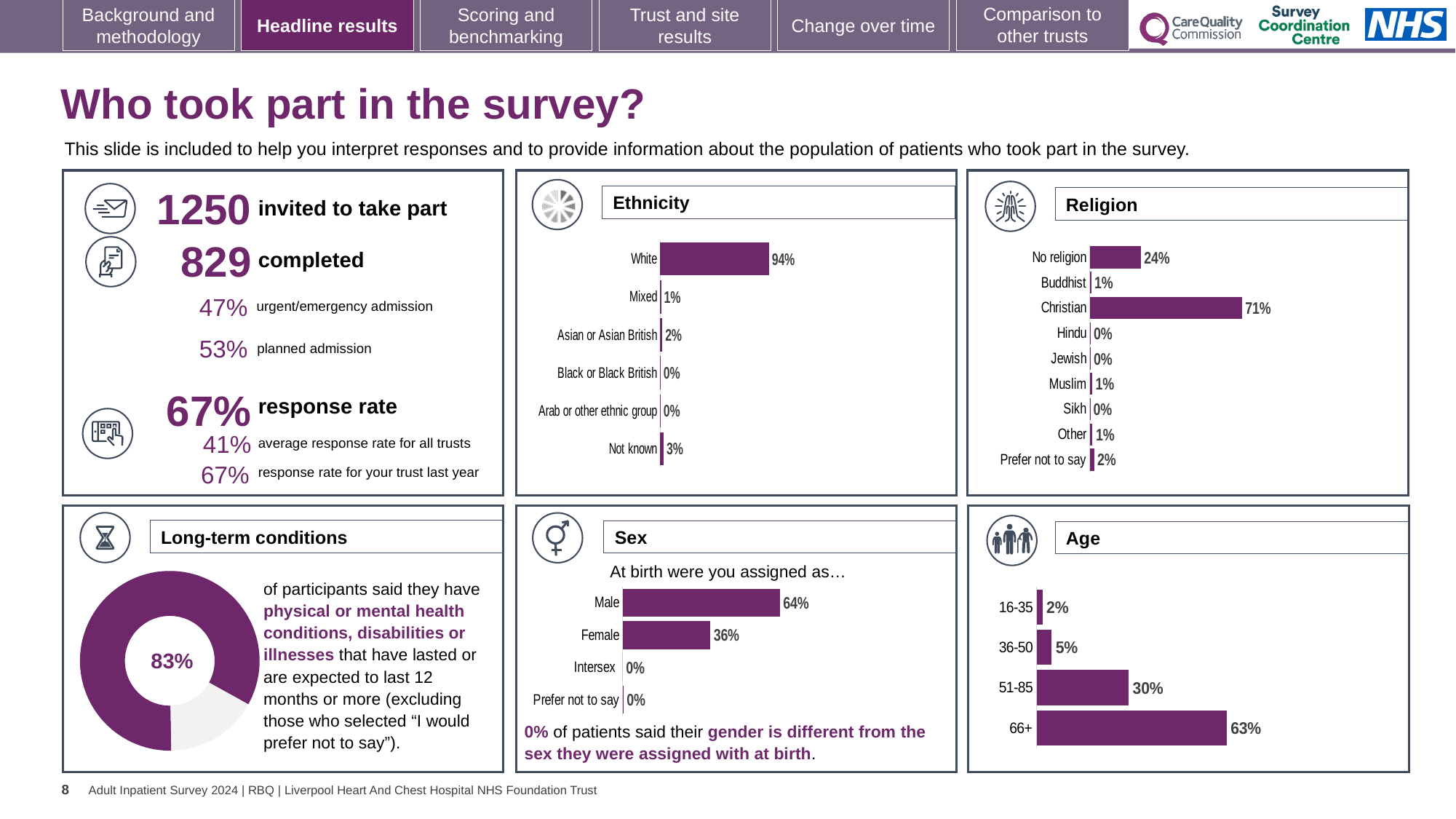
In the Ethnicity chart, how many categories are shown? 6 In the Ethnicity chart, which category has the highest value? White In the Sex chart, what percentage of respondents are Female? 36% What kind of chart is used in the Long-term conditions panel? doughnut chart In the Ethnicity chart, what percentage of respondents are White? 94% In the Age chart, what percentage of respondents are aged 66+? 63% In the Religion chart, what percentage of respondents are Christian? 71% In the Age chart, what is the difference between the 66+ and 51-85 values? 33% In the Religion chart, how many categories are shown? 9 In the Age chart, do the values rise or fall as age increases from 16-35 to 66+? rise In the Sex chart, which is larger, Male or Female? Male In the Religion chart, what is the difference between the Christian and No religion values? 47%